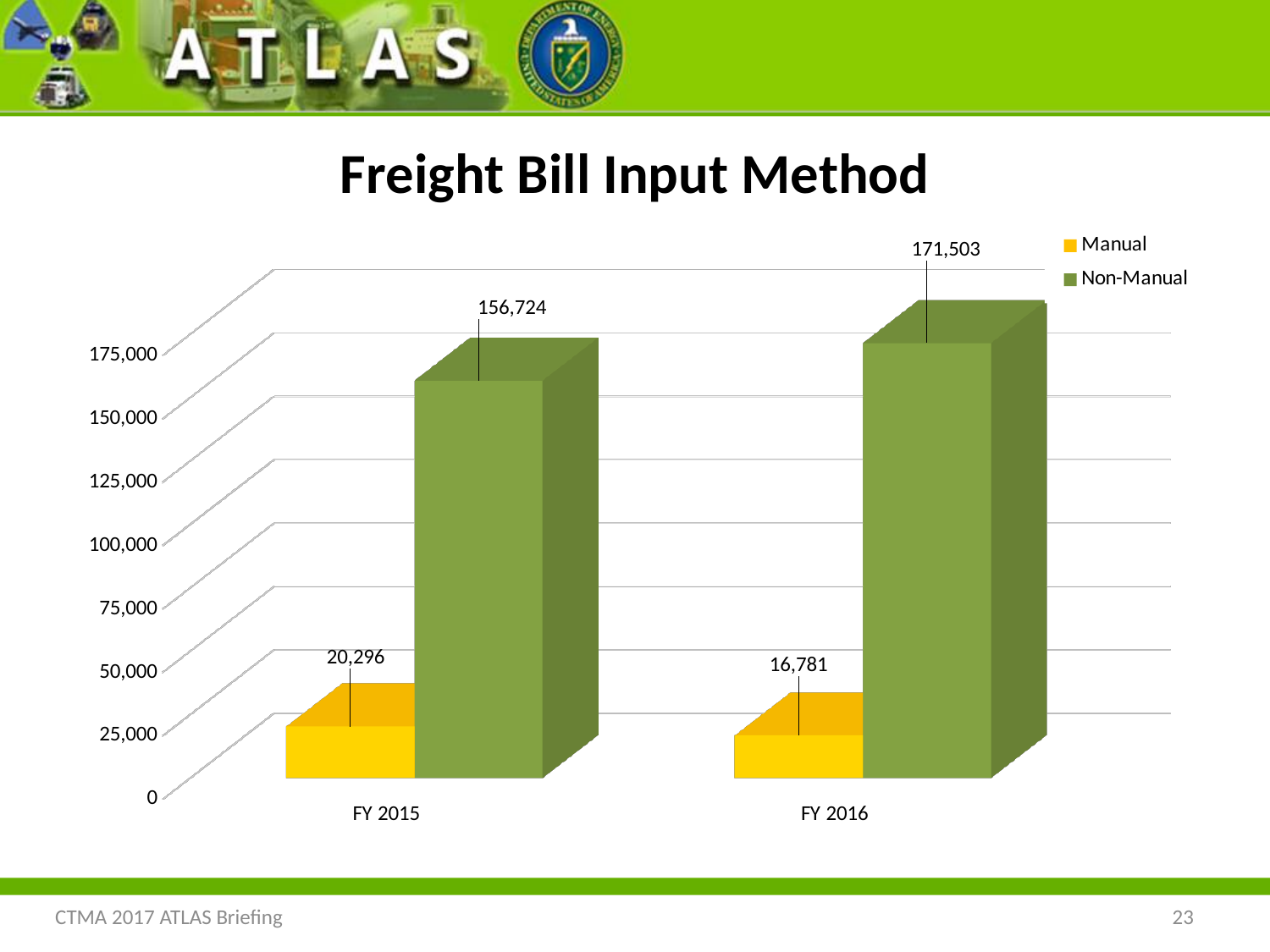
What is the Non-Manual value for FY 2015? 156,724 What is the title of the chart? Freight Bill Input Method How many series does the legend list? 2 What is the difference between the Non-Manual values for FY 2016 and FY 2015? 14,779 What is the Non-Manual value for FY 2016? 171,503 What is the Manual value for FY 2015? 20,296 What is the difference between the Manual values for FY 2015 and FY 2016? 3,515 Is the Manual value for FY 2015 larger or smaller than the Manual value for FY 2016? larger What kind of chart is shown on the slide? bar chart Which fiscal year has the higher Non-Manual value? FY 2016 Which fiscal year has the lower Manual value? FY 2016 What is the Manual value for FY 2016? 16,781